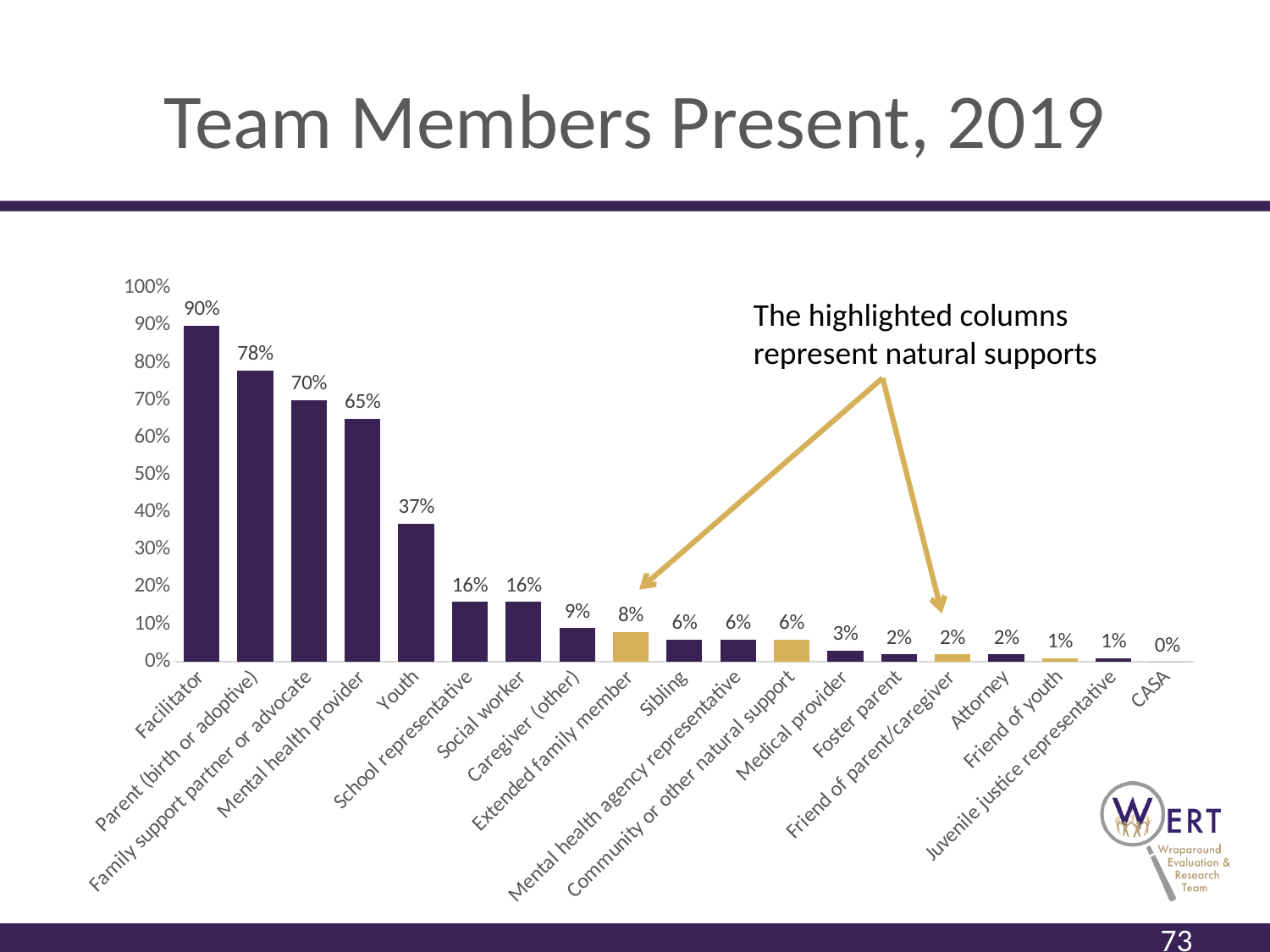
Which team member category has the lowest value? CASA According to the annotation, what do the highlighted columns represent? natural supports What is the value for Youth? 37% What percentage of teams had a Facilitator present? 90% Which team member category has the highest value? Facilitator What is the value for Extended family member? 8% Is the value for Youth greater or less than 50%? less Do the values rise or fall moving from left to right along the x axis? fall Which is larger, the value for Mental health provider or the value for Family support partner or advocate? Family support partner or advocate How many team member categories are shown on the chart? 19 What is the difference between the values for Facilitator and Parent (birth or adoptive)? 12% What kind of chart is shown on the slide? bar chart